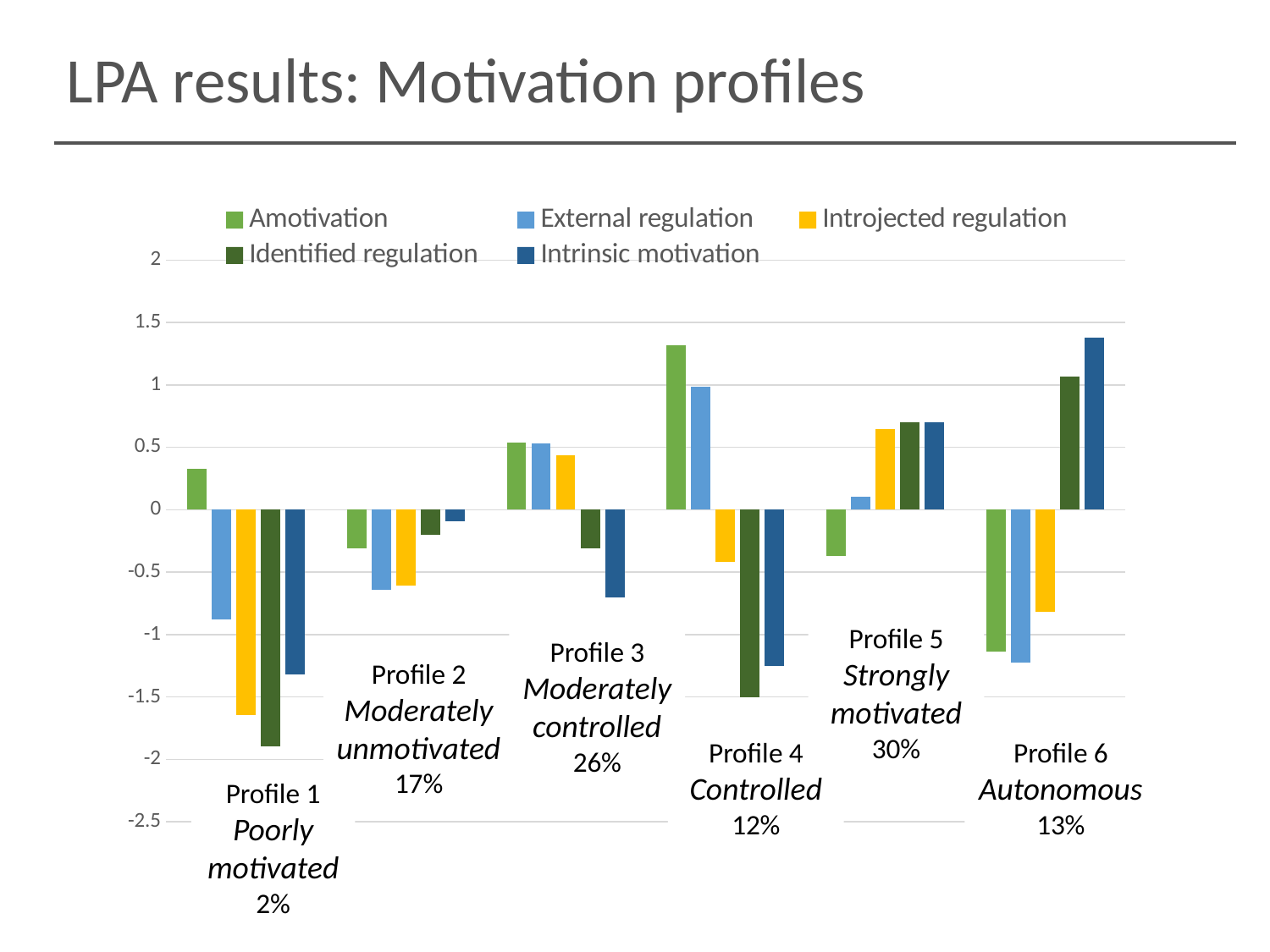
Is the External regulation value for Profile 1 greater or less than -0.5? less Is the Intrinsic motivation value for Profile 6 greater or less than 1? greater Is the Amotivation value for Profile 4 greater or less than 1? greater Which profile has the highest Intrinsic motivation value? Profile 6 How many series does the legend list? 5 Which is larger, the Amotivation value for Profile 4 or for Profile 3? Profile 4 What kind of chart is shown on the slide? bar chart How many motivation profiles are shown on the x axis? 6 Which profile has the lowest Identified regulation value? Profile 1 Which profile has the highest Amotivation value? Profile 4 What percentage is shown for Profile 5 (Strongly motivated)? 30%